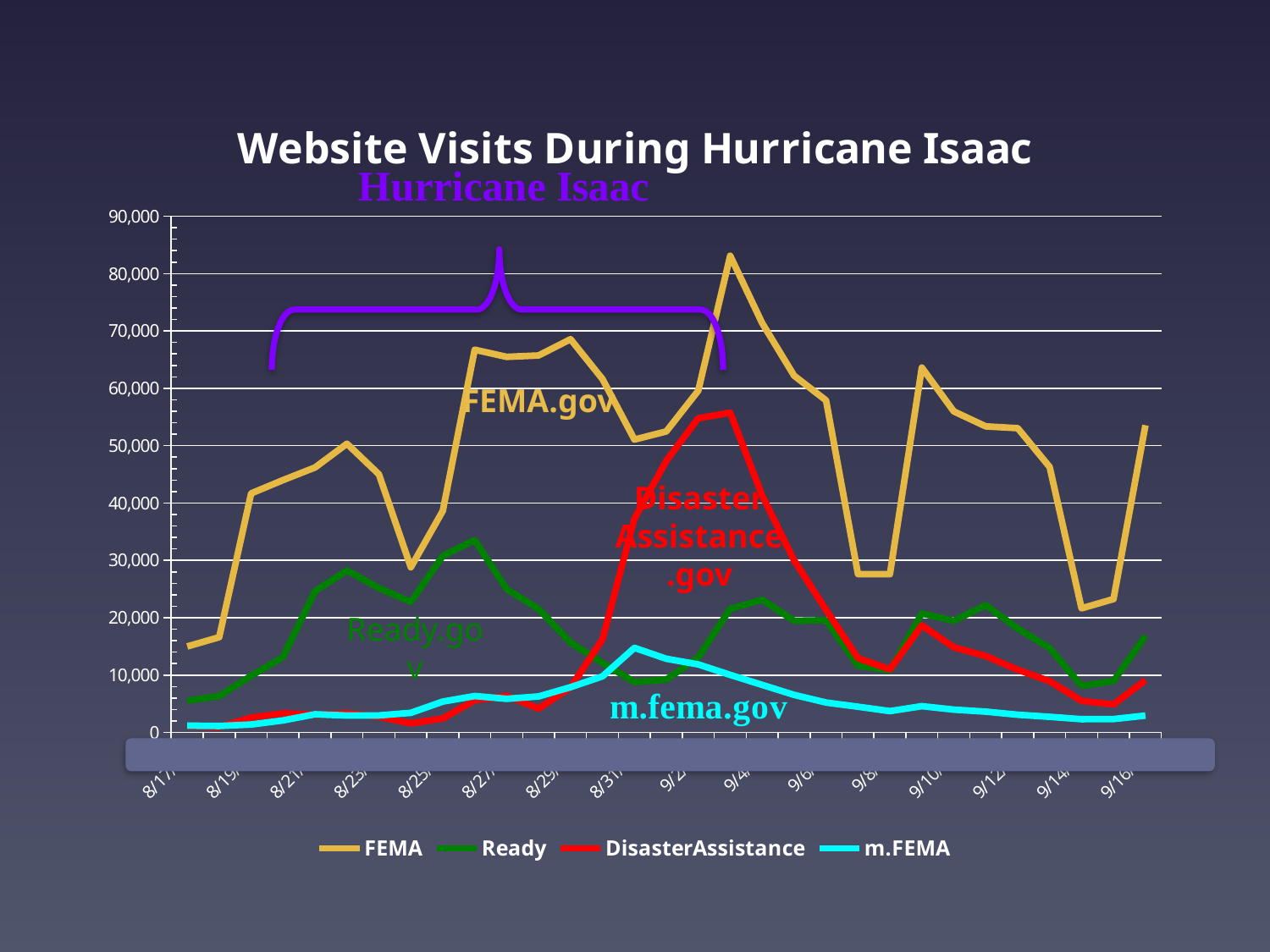
Which colour is used for the DisasterAssistance series? Red Which series stays lowest across most of the chart? m.FEMA How many date labels are shown on the x axis? 16 Which series reaches the highest value on the chart? FEMA Is the peak value of the FEMA series greater or less than 80,000? greater What kind of chart is shown on the slide? Line chart Is the peak value of the DisasterAssistance series greater or less than 50,000? greater What is the title of the chart? Website Visits During Hurricane Isaac Is the peak value of the m.FEMA series greater or less than 20,000? less How many series does the legend list? 4 On 9/4, which series has the larger value, FEMA or DisasterAssistance? FEMA